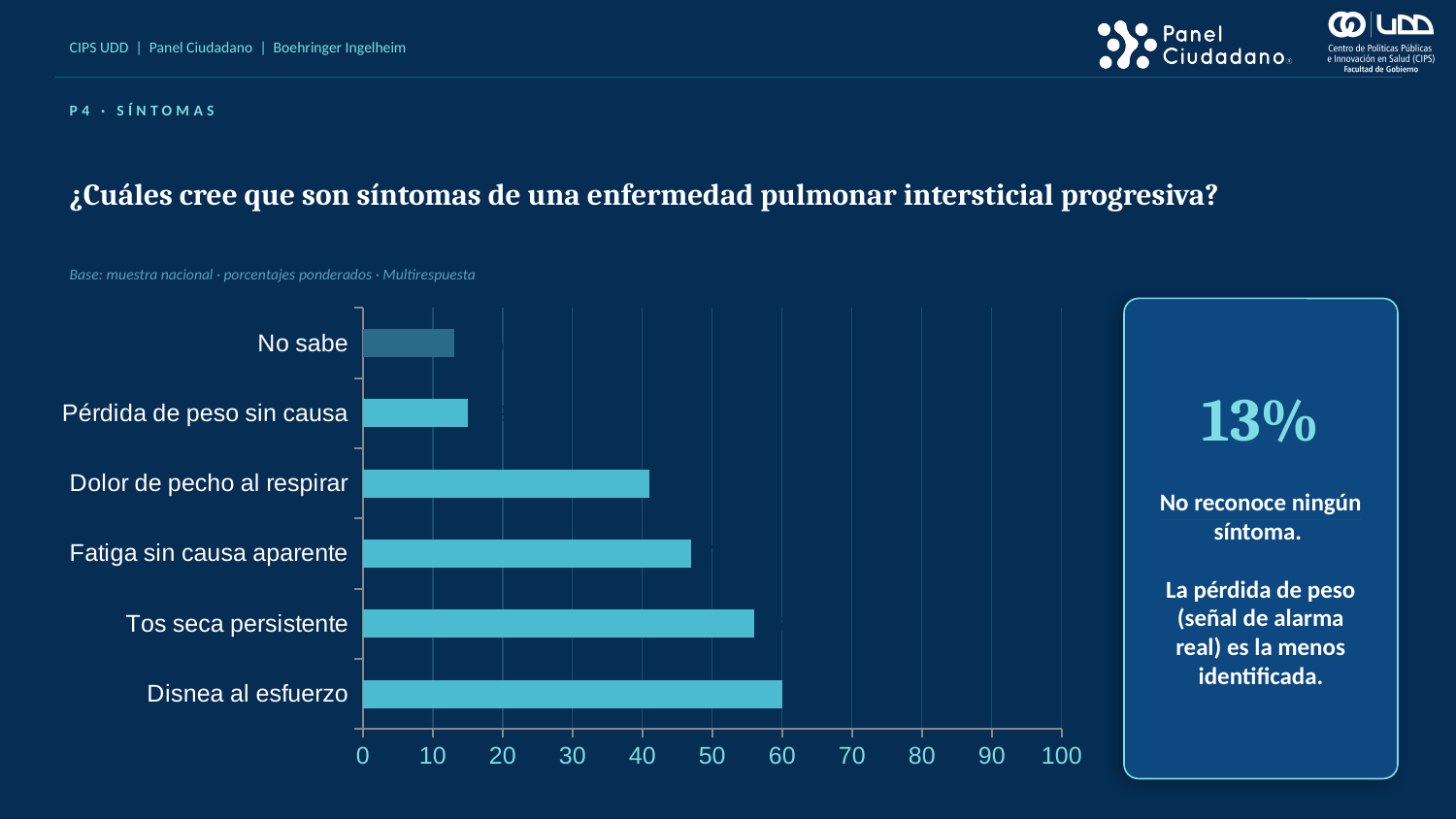
Is the value for Tos seca persistente greater or less than 50? greater Is the value for Fatiga sin causa aparente greater or less than 50? less Is the value for Disnea al esfuerzo greater or less than 50? greater What percentage is highlighted in the callout box to the right of the chart? 13% What question is the chart on the slide answering, according to the slide title? ¿Cuáles cree que son síntomas de una enfermedad pulmonar intersticial progresiva? How many symptom categories are plotted in the bar chart? 6 Which has a larger value, Tos seca persistente or Fatiga sin causa aparente? Tos seca persistente Which has a larger value, Dolor de pecho al respirar or Pérdida de peso sin causa? Dolor de pecho al respirar Which category has the highest value in the bar chart? Disnea al esfuerzo What kind of chart is shown on the slide? bar chart